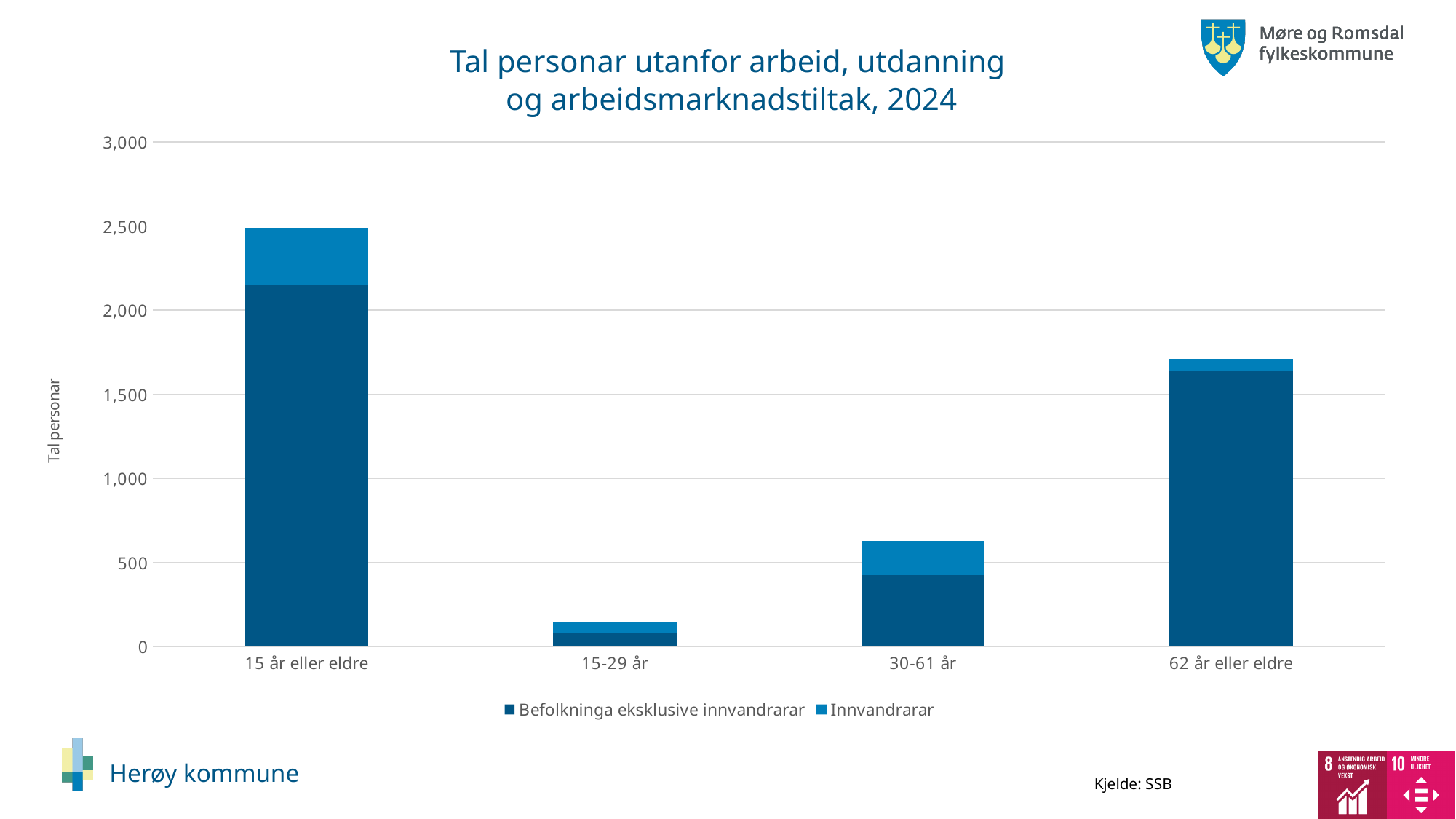
What are the two series named in the legend? Befolkninga eksklusive innvandrarar; Innvandrarar Is the total stacked value for 30-61 år greater or less than 500? greater How many series does the legend list? 2 Which age category has the tallest stacked bar? 15 år eller eldre Is the total stacked value for 62 år eller eldre greater or less than 1,500? greater Which stacked bar is taller: 30-61 år or 62 år eller eldre? 62 år eller eldre Which age category has the shortest stacked bar? 15-29 år What kind of chart is shown on the slide? bar chart What is the label on the y axis? Tal personar Is the total stacked value for 15 år eller eldre greater or less than 2,000? greater How many age categories are shown on the x axis? 4